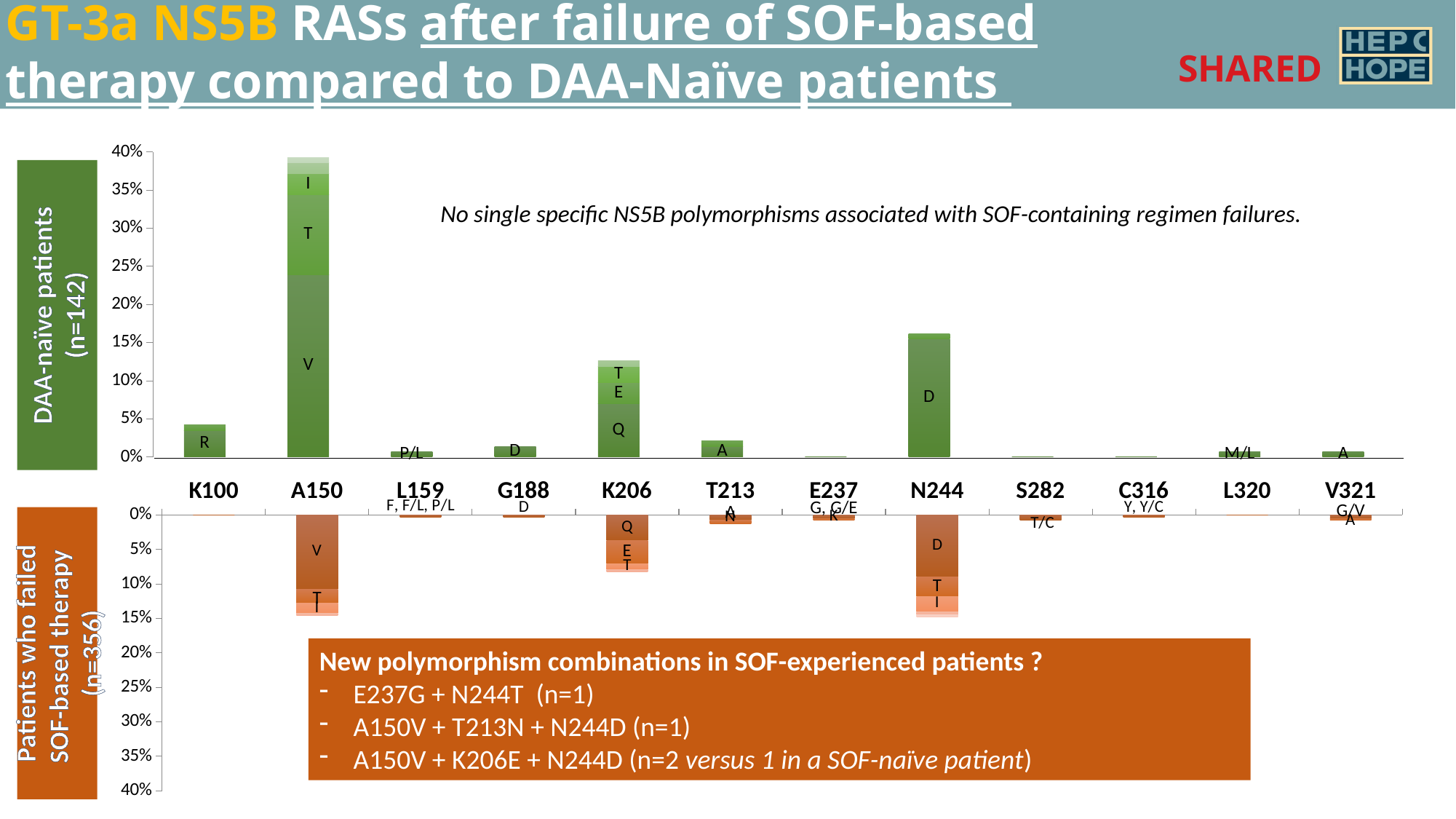
What is the number of patients in the group who failed SOF-based therapy, as shown on the chart's side label? n=356 In the DAA-naïve patients chart, which is larger, the bar for N244 or the bar for K206? N244 What kind of chart is used for the DAA-naïve patients (n=142) panel? bar chart In the chart for patients who failed SOF-based therapy, is the value for A150 greater or less than 10%? greater In the chart for patients who failed SOF-based therapy, which is larger, the bar for A150 or the bar for K206? A150 In the DAA-naïve patients chart, which position has the highest bar? A150 In the DAA-naïve patients chart, which is larger, the bar for K100 or the bar for T213? K100 In the DAA-naïve patients chart, is the value for A150 greater or less than 35%? greater In the DAA-naïve patients chart, is the value for K206 greater or less than 10%? greater In the DAA-naïve patients chart, how many NS5B positions are shown on the x axis? 12